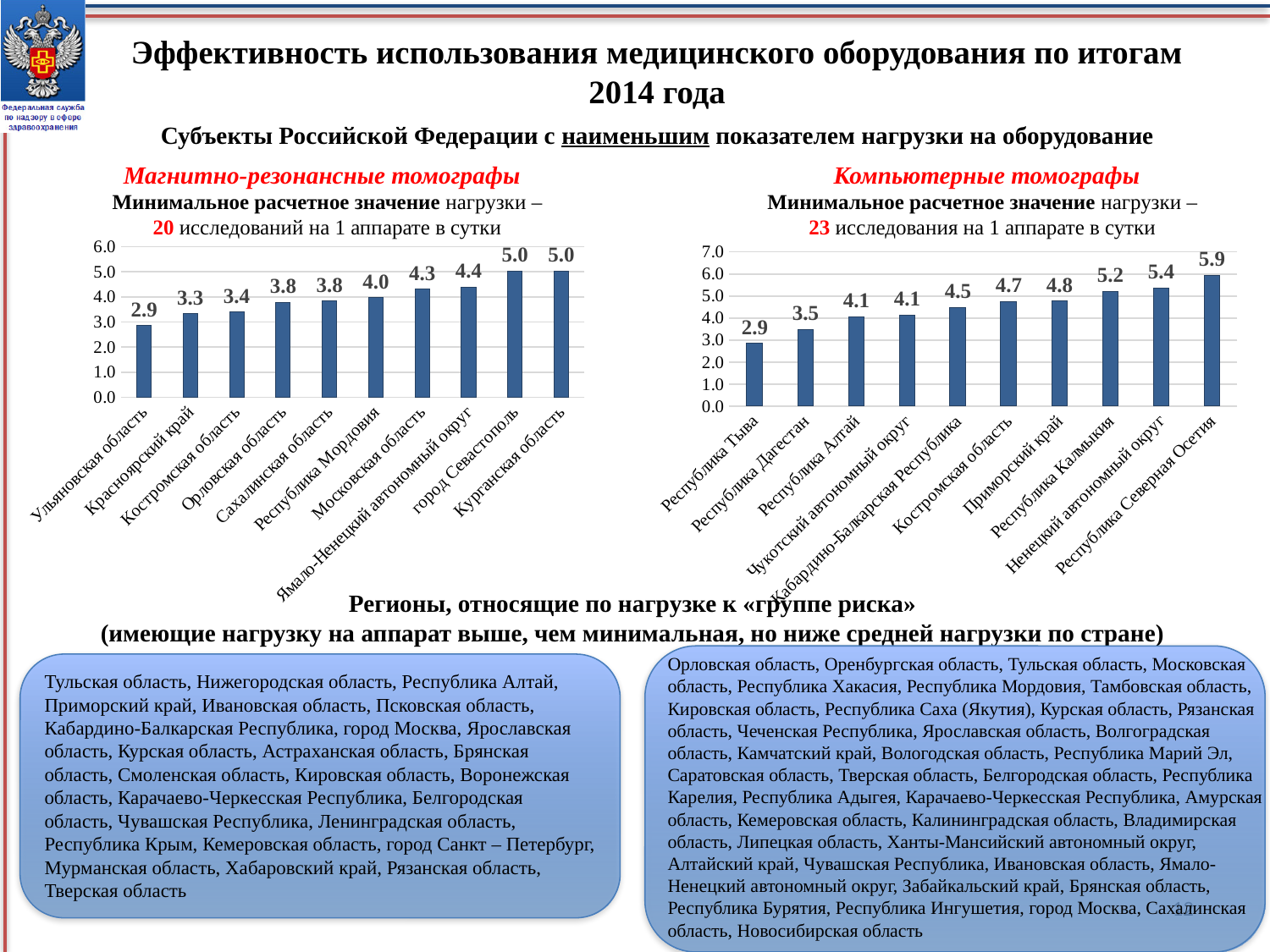
On the right chart (Компьютерные томографы), what is the value for Республика Калмыкия? 5.2 On the right chart (Компьютерные томографы), do the values rise or fall from left to right? Rise On the right chart (Компьютерные томографы), what is the difference between the values for Ненецкий автономный округ and Республика Дагестан? 1.9 How many regions are shown on the left chart (Магнитно-резонансные томографы)? 10 On the right chart (Компьютерные томографы), which region has the lowest value? Республика Тыва On the right chart (Компьютерные томографы), which is larger: the value for Приморский край or Кабардино-Балкарская Республика? Приморский край On the left chart (Магнитно-резонансные томографы), what is the value for Московская область? 4.3 On the left chart (Магнитно-резонансные томографы), what is the difference between the values for Курганская область and Ульяновская область? 2.1 What type of chart is the right chart (Компьютерные томографы)? Bar chart On the left chart (Магнитно-резонансные томографы), which region has the lowest value? Ульяновская область On the right chart (Компьютерные томографы), which region has the highest value? Республика Северная Осетия On the left chart (Магнитно-резонансные томографы), what is the value for Ульяновская область? 2.9